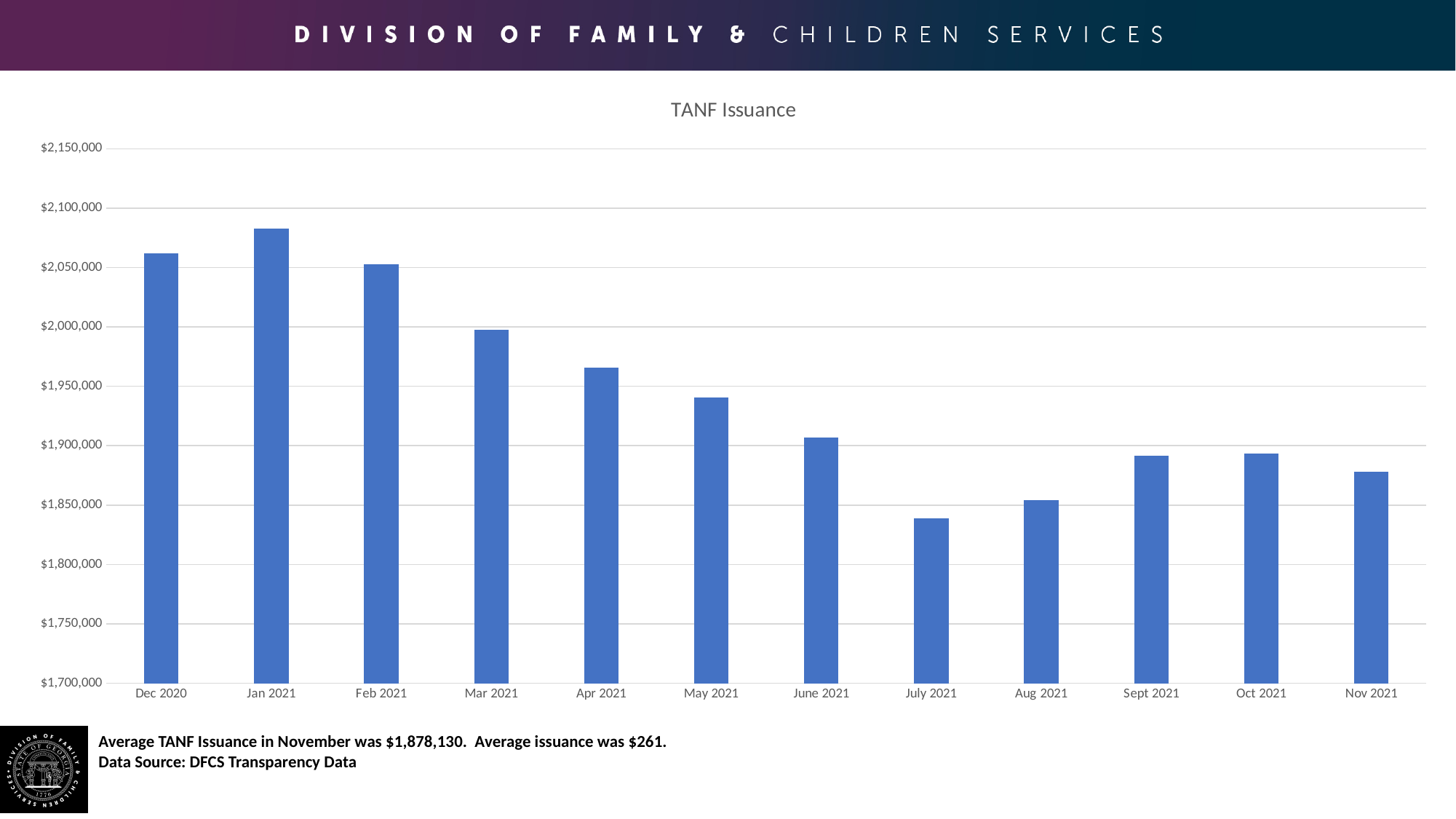
Is the TANF issuance for July 2021 greater or less than $1,850,000? less What kind of chart is shown on the slide? Bar chart What is the title of the chart? TANF Issuance Which is larger, the TANF issuance for Dec 2020 or for Mar 2021? Dec 2020 Is the TANF issuance for Apr 2021 greater or less than $1,950,000? greater Which month has the highest TANF issuance? Jan 2021 Is the TANF issuance for Sept 2021 greater or less than $1,900,000? less What was the TANF issuance in Nov 2021, as stated on the slide? $1,878,130 Which month has the lowest TANF issuance? July 2021 How many months are plotted on the x axis of the TANF Issuance chart? 12 Does the TANF issuance rise or fall from Jan 2021 to July 2021? Fall